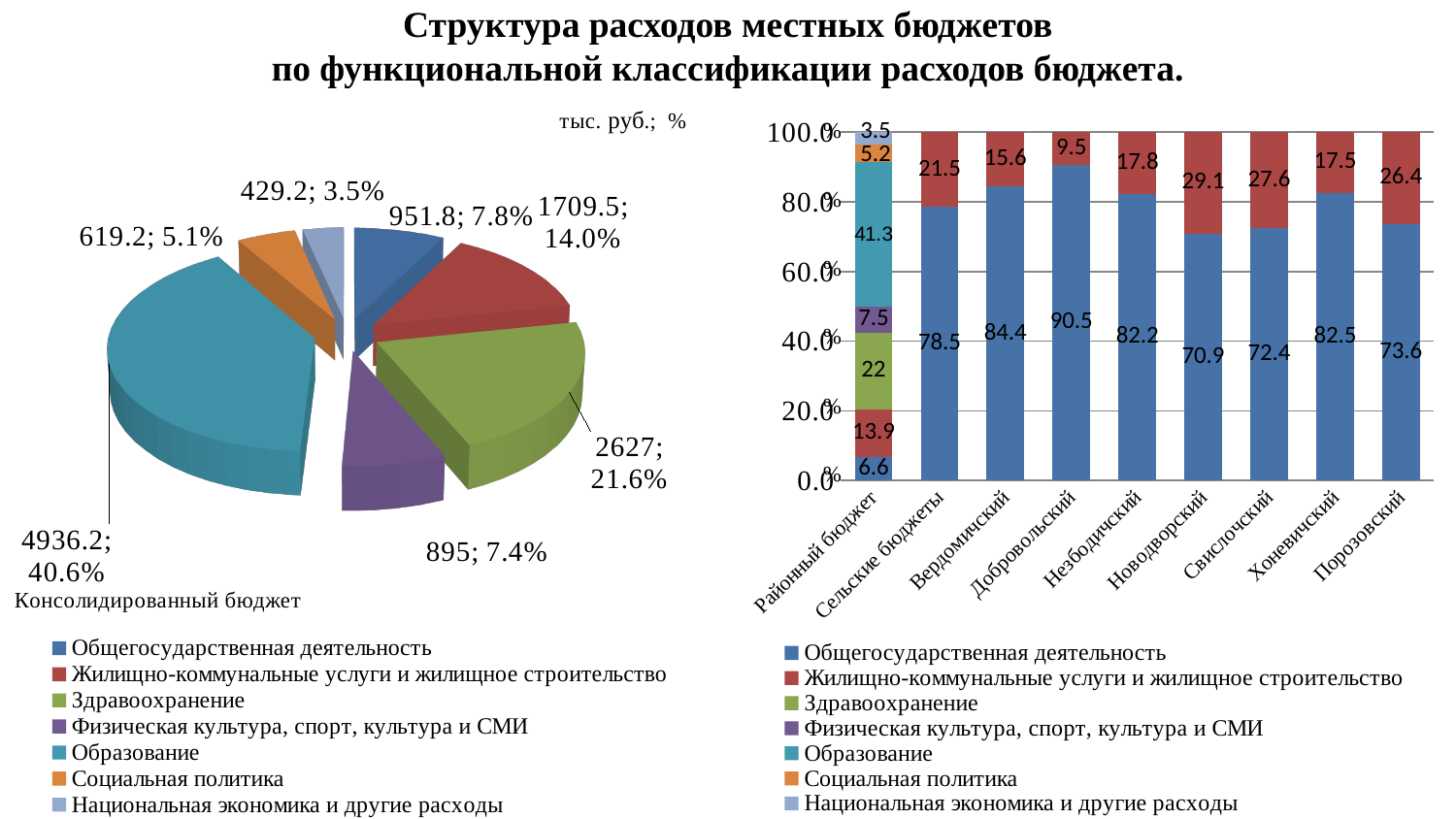
In the stacked bar chart on the right, what is the value of Общегосударственная деятельность for Добровольский? 90.5 In the stacked bar chart on the right, which budget has the lowest value for Общегосударственная деятельность? Районный бюджет In the stacked bar chart on the right, how many series does the legend list? 7 In the pie chart (Консолидированный бюджет), what is the value in тыс. руб. for Здравоохранение? 2627 In the pie chart (Консолидированный бюджет), what share does Образование have? 40.6% In the stacked bar chart on the right, what is the difference between the Жилищно-коммунальные услуги values for Новодворский and Свислочский? 1.5 In the pie chart (Консолидированный бюджет), which category has the largest slice? Образование In the stacked bar chart on the right, what is the value of Образование for Районный бюджет? 41.3 In the pie chart (Консолидированный бюджет), which category has the smallest slice? Национальная экономика и другие расходы In the stacked bar chart on the right, how many budgets are shown on the x axis? 9 What type of chart is shown on the right side of the slide? Stacked bar chart In the stacked bar chart on the right, which budget has the highest value for Общегосударственная деятельность? Добровольский